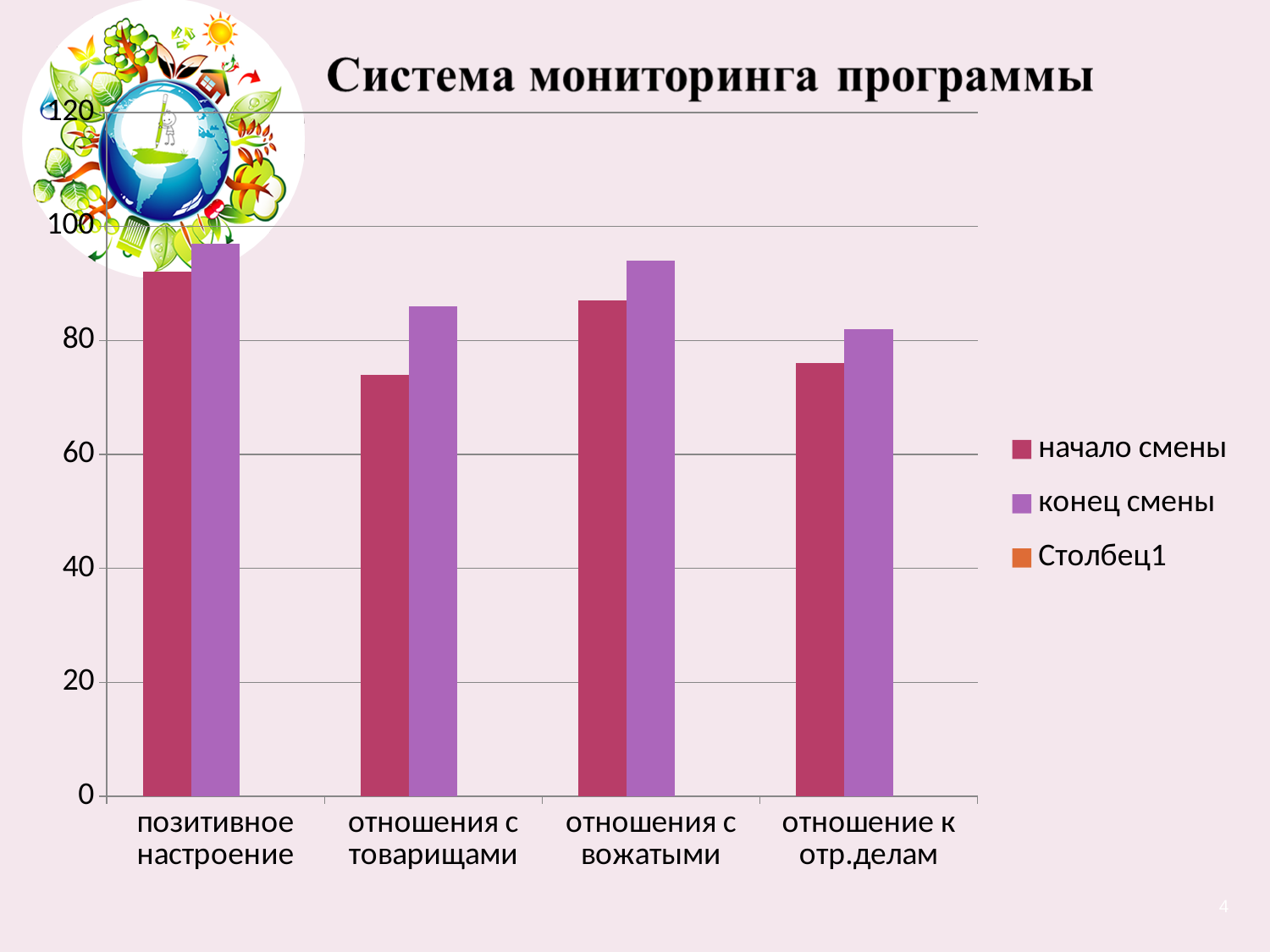
For 'отношение к отр.делам', which is larger: 'начало смены' or 'конец смены'? конец смены How many series does the chart legend list? 3 What is the title of the slide containing the chart? Система мониторинга программы Is the value for 'начало смены' in 'позитивное настроение' greater or less than 80? greater For 'начало смены', which is larger: 'позитивное настроение' or 'отношения с вожатыми'? позитивное настроение Is the value for 'начало смены' in 'отношения с товарищами' greater or less than 80? less How many categories are shown along the x axis of the chart? 4 Is the value for 'конец смены' in 'отношения с товарищами' greater or less than 80? greater Which category has the highest value for 'начало смены'? позитивное настроение What kind of chart is shown on the slide? bar chart Which legend entry is shown in orange? Столбец1